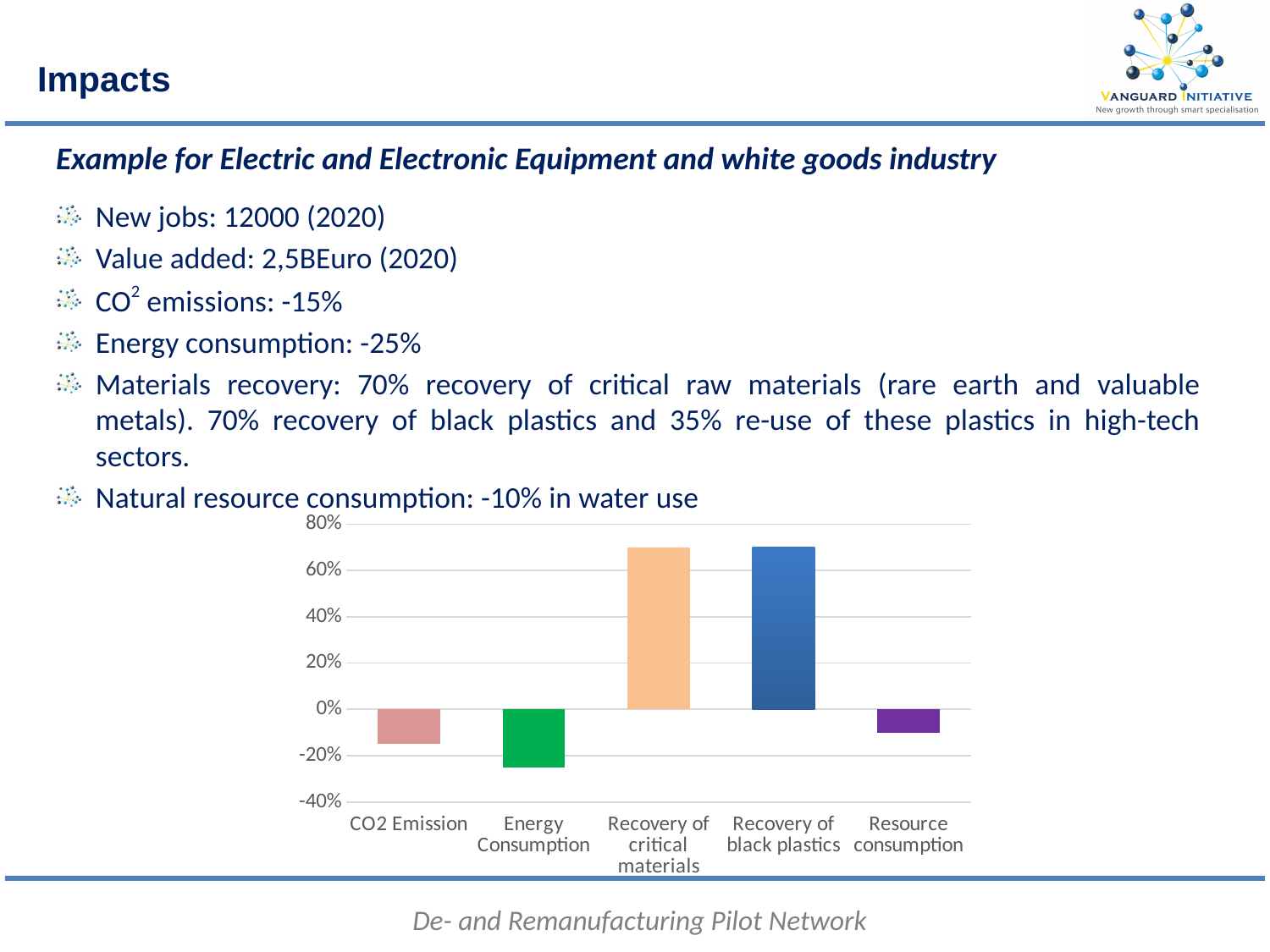
Is the value for Recovery of critical materials greater or less than 60%? greater Is the value for Energy Consumption greater or less than -20%? less What kind of chart is shown on the slide? bar chart Is the value for Resource consumption greater or less than -20%? greater Which category has the lowest value in the chart? Energy Consumption What is the highest value shown on the vertical axis of the chart? 80% How many categories are plotted in the chart? 5 Which is larger, the value for Recovery of black plastics or the value for Resource consumption? Recovery of black plastics What colour is the bar for Energy Consumption? green Which is larger, the value for CO2 Emission or the value for Energy Consumption? CO2 Emission